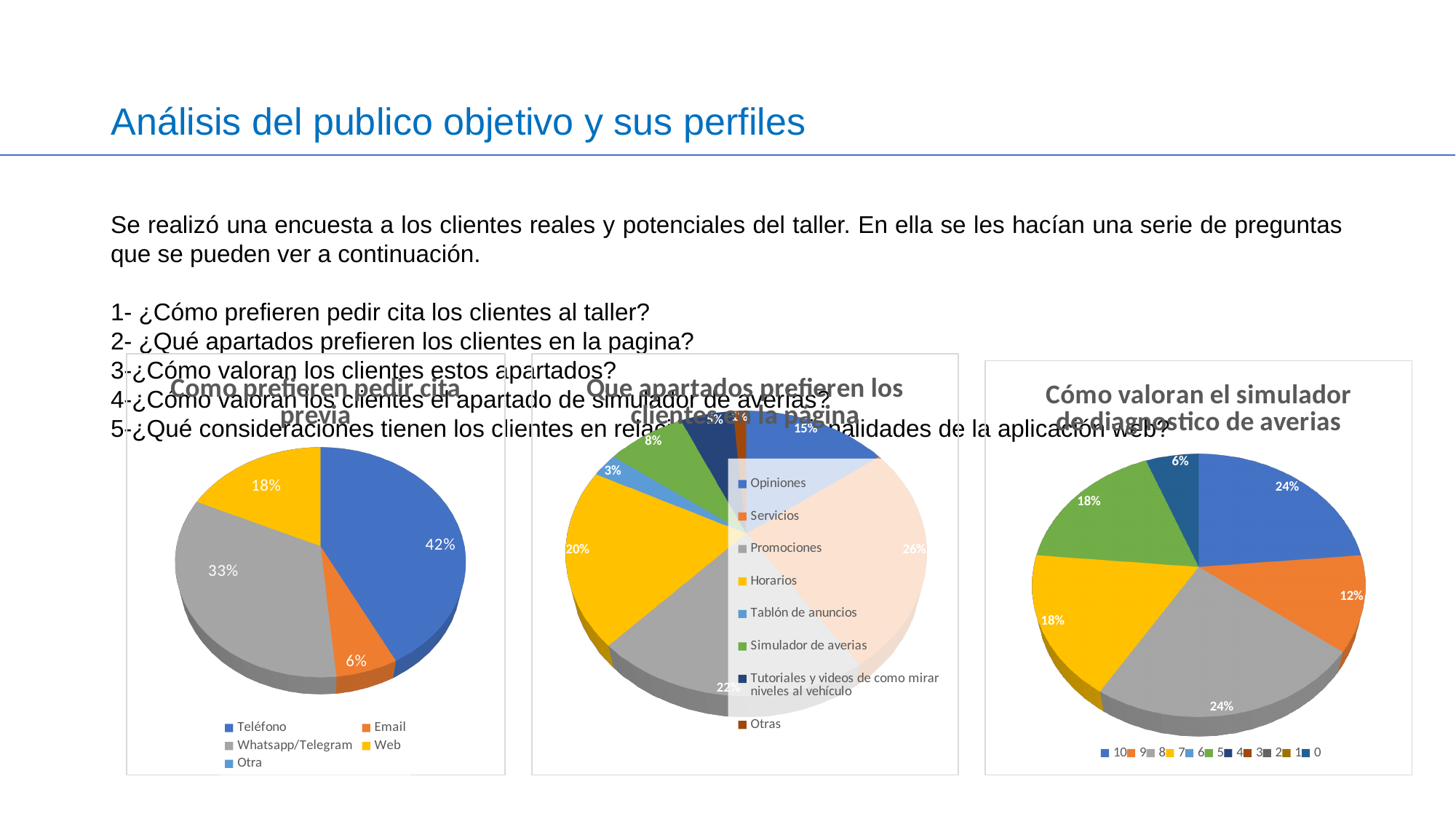
In the 'Que apartados prefieren los clientes en la pagina' chart, which is larger: Promociones or Opiniones? Promociones In the 'Como prefieren pedir cita previa' chart, what is the difference between the Teléfono and Web shares? 24% In the 'Como prefieren pedir cita previa' chart, what share is Teléfono? 42% How many entries does the legend of the 'Como prefieren pedir cita previa' chart list? 5 What kind of chart is the 'Como prefieren pedir cita previa' chart? Pie chart In the 'Que apartados prefieren los clientes en la pagina' chart, which category has the largest share? Servicios In the 'Que apartados prefieren los clientes en la pagina' chart, what share is Horarios? 20% In the 'Como prefieren pedir cita previa' chart, which category has the largest share? Teléfono In the 'Que apartados prefieren los clientes en la pagina' chart, what share is Servicios? 26% How many entries does the legend of the 'Cómo valoran el simulador de diagnostico de averias' chart list? 11 In the 'Como prefieren pedir cita previa' chart, what share is Whatsapp/Telegram? 33% In the 'Cómo valoran el simulador de diagnostico de averias' chart, what share is the rating 9? 12%